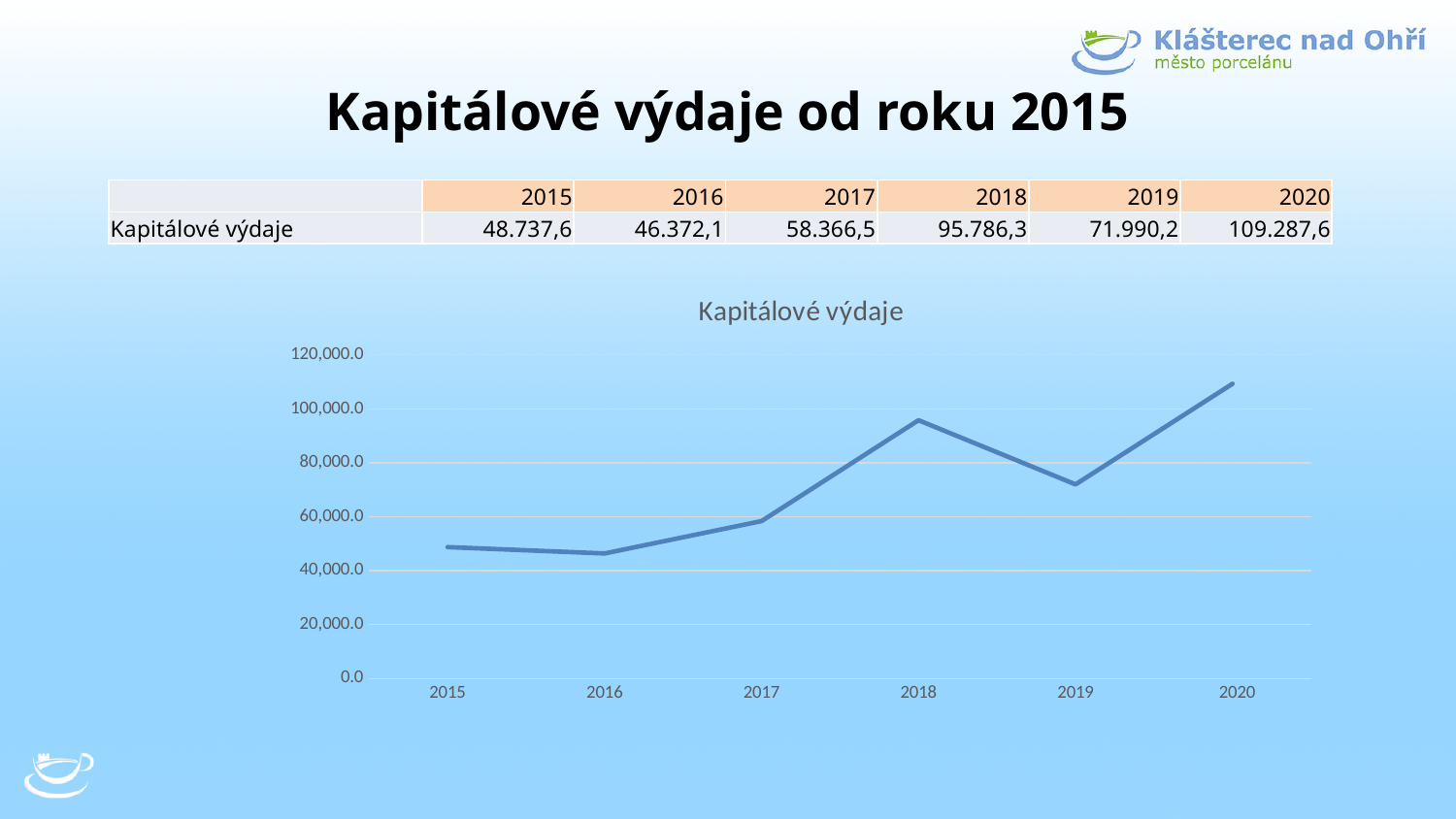
Is the value for 2020 greater or less than 100,000.0? greater Is the value for 2019 greater or less than 80,000.0? less What type of chart is shown on the slide? line chart How many years are plotted on the x axis of the chart? 6 Which is larger, the value for 2017 or the value for 2019? 2019 Which year has the lowest value of Kapitálové výdaje? 2016 According to the table, what is the value of Kapitálové výdaje for 2018? 95.786,3 Does the line rise or fall between 2018 and 2019? fall Which year has the highest value of Kapitálové výdaje? 2020 According to the table, what is the value of Kapitálové výdaje for 2016? 46.372,1 What is the difference between the values for 2020 and 2015 in the table? 60.550,0 What is the title of the chart? Kapitálové výdaje